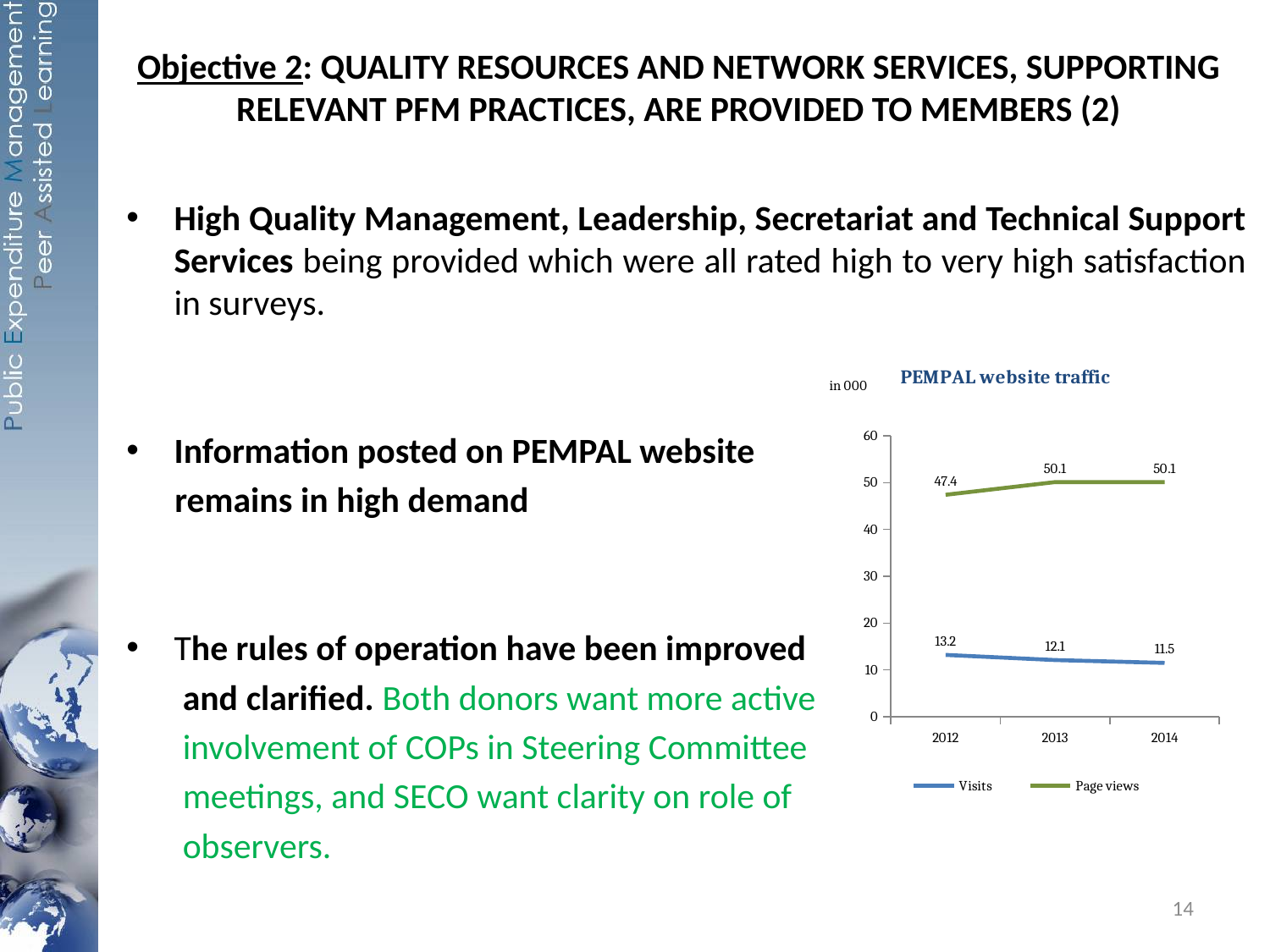
In which year is the Page views series lowest? 2012 Which is larger in 2014, Visits or Page views? Page views What is the difference between Visits in 2012 and Visits in 2014? 1.7 What is the value for Page views in 2013? 50.1 What is the difference between Page views and Visits in 2012? 34.2 How many series does the legend list? 2 What kind of chart is shown on the slide? line chart What is the value for Visits in 2014? 11.5 Is the value for Page views in 2012 greater or less than 40? greater In which year is the Visits series lowest? 2014 How many years are shown on the x axis? 3 What is the value for Visits in 2012? 13.2